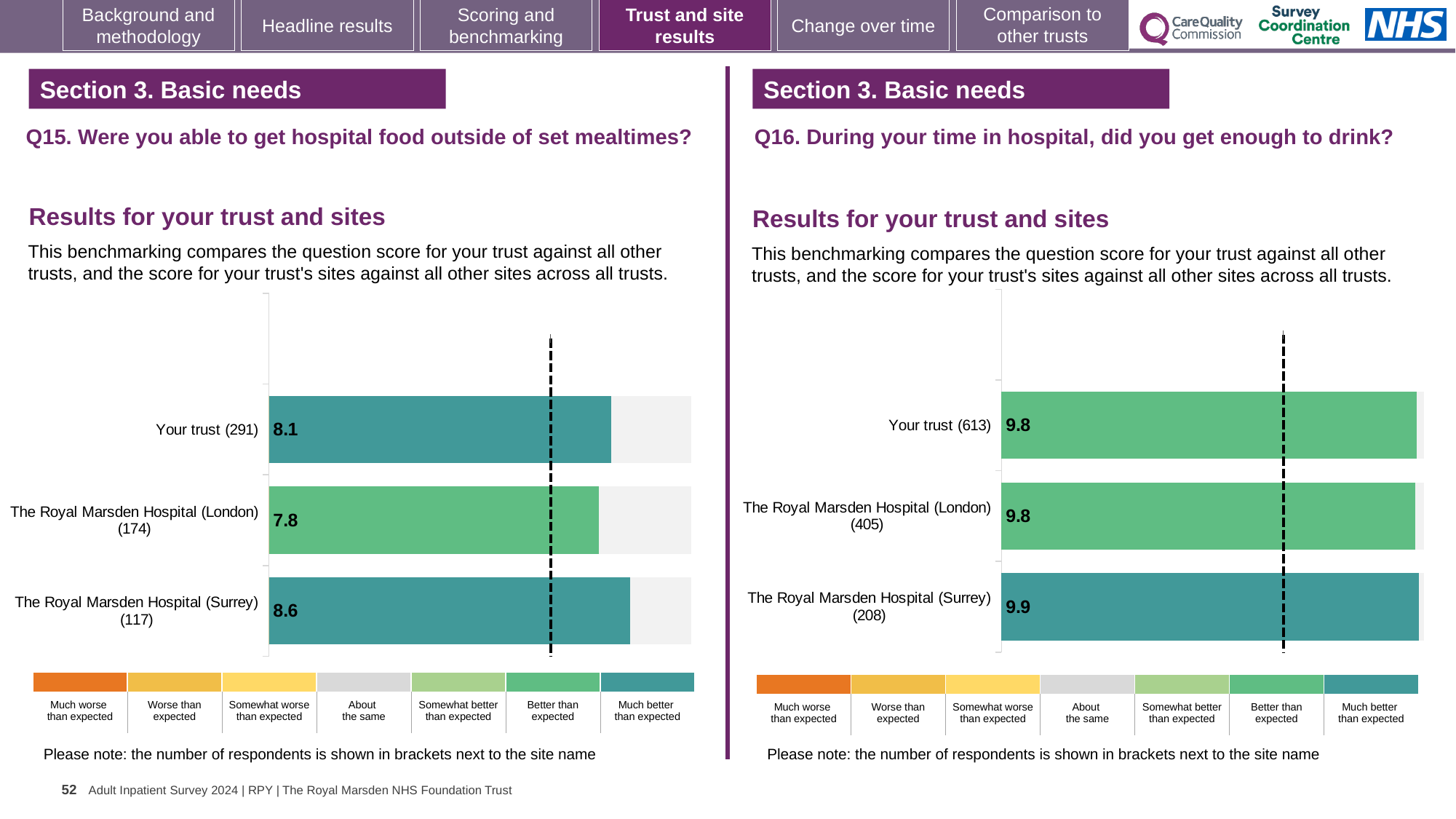
On the Q16 chart (right), what is the score for Your trust? 9.8 On the Q16 chart (right), what is the score for The Royal Marsden Hospital (Surrey)? 9.9 What kind of chart is used on the Q15 chart (left)? Bar chart On the Q15 chart (left), how many respondents are shown for The Royal Marsden Hospital (London)? 174 On the Q15 chart (left), what is the difference between the scores for The Royal Marsden Hospital (Surrey) and The Royal Marsden Hospital (London)? 0.8 On the Q15 chart (left), which has the higher score: Your trust or The Royal Marsden Hospital (London)? Your trust On the Q15 chart (left), what is the score for Your trust? 8.1 On the Q15 chart (left), what is the score for The Royal Marsden Hospital (Surrey)? 8.6 On the Q16 chart (right), how many bars are plotted? 3 On the Q15 chart (left), which site or trust has the lowest score? The Royal Marsden Hospital (London) On the Q16 chart (right), which site or trust has the highest score? The Royal Marsden Hospital (Surrey) On the Q16 chart (right), how many categories does the colour key below the chart list? 7